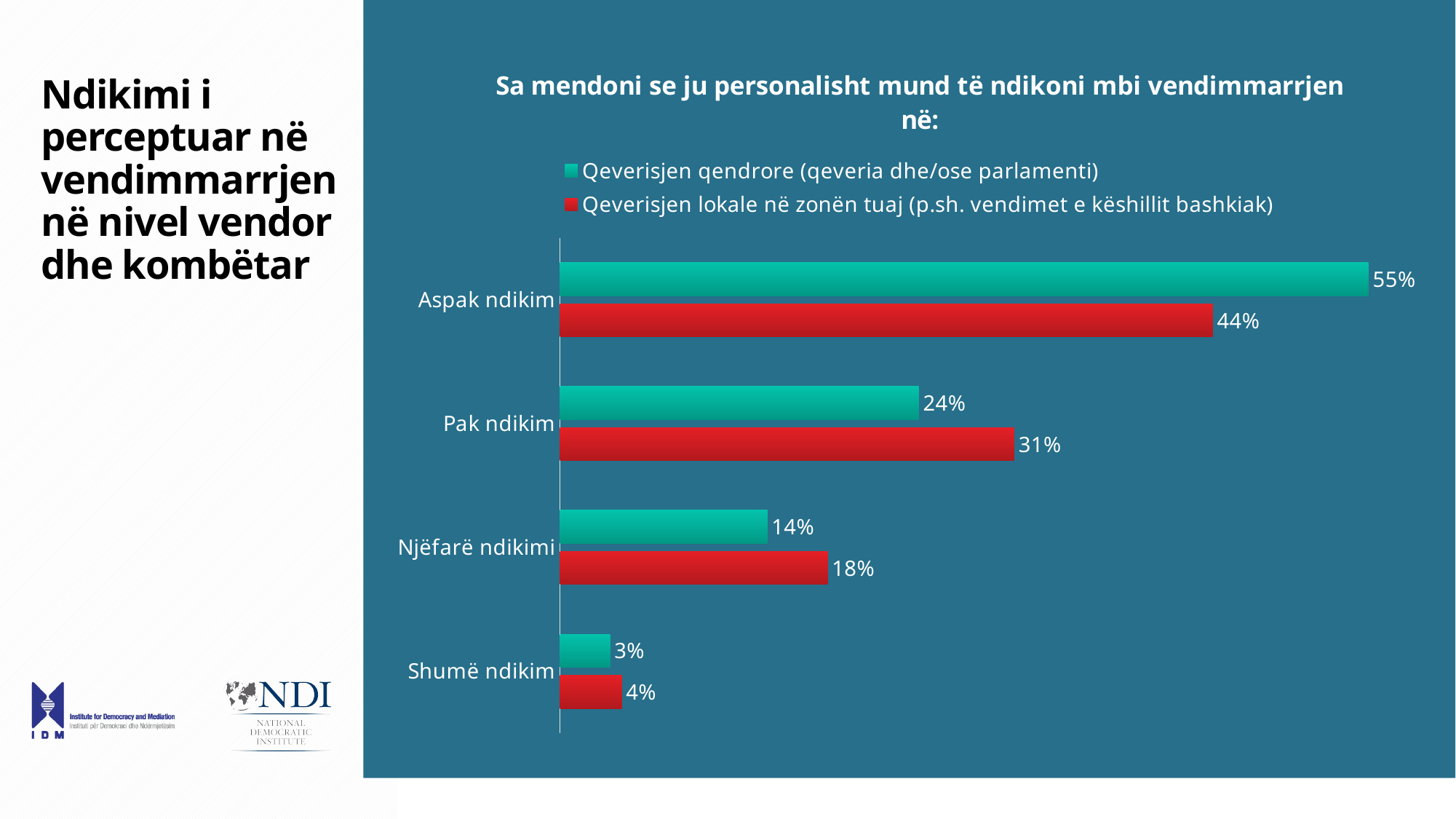
What is the difference between the two series' values for "Pak ndikim"? 7% How many categories are shown on the chart? 4 How many series does the legend list? 2 Which category has the highest value in the "Qeverisjen qendrore (qeveria dhe/ose parlamenti)" series? Aspak ndikim What kind of chart is shown on the slide? Bar chart What is the value for "Njëfarë ndikimi" in the "Qeverisjen lokale në zonën tuaj (p.sh. vendimet e këshillit bashkiak)" series? 18% What is the value for "Pak ndikim" in the "Qeverisjen lokale në zonën tuaj (p.sh. vendimet e këshillit bashkiak)" series? 31% For "Njëfarë ndikimi", which series has the larger value? Qeverisjen lokale në zonën tuaj (p.sh. vendimet e këshillit bashkiak) What is the value for "Aspak ndikim" in the "Qeverisjen qendrore (qeveria dhe/ose parlamenti)" series? 55% What is the difference between the two series' values for "Aspak ndikim"? 11% What is the value for "Shumë ndikim" in the "Qeverisjen qendrore (qeveria dhe/ose parlamenti)" series? 3% Which category has the lowest value in the "Qeverisjen lokale në zonën tuaj (p.sh. vendimet e këshillit bashkiak)" series? Shumë ndikim